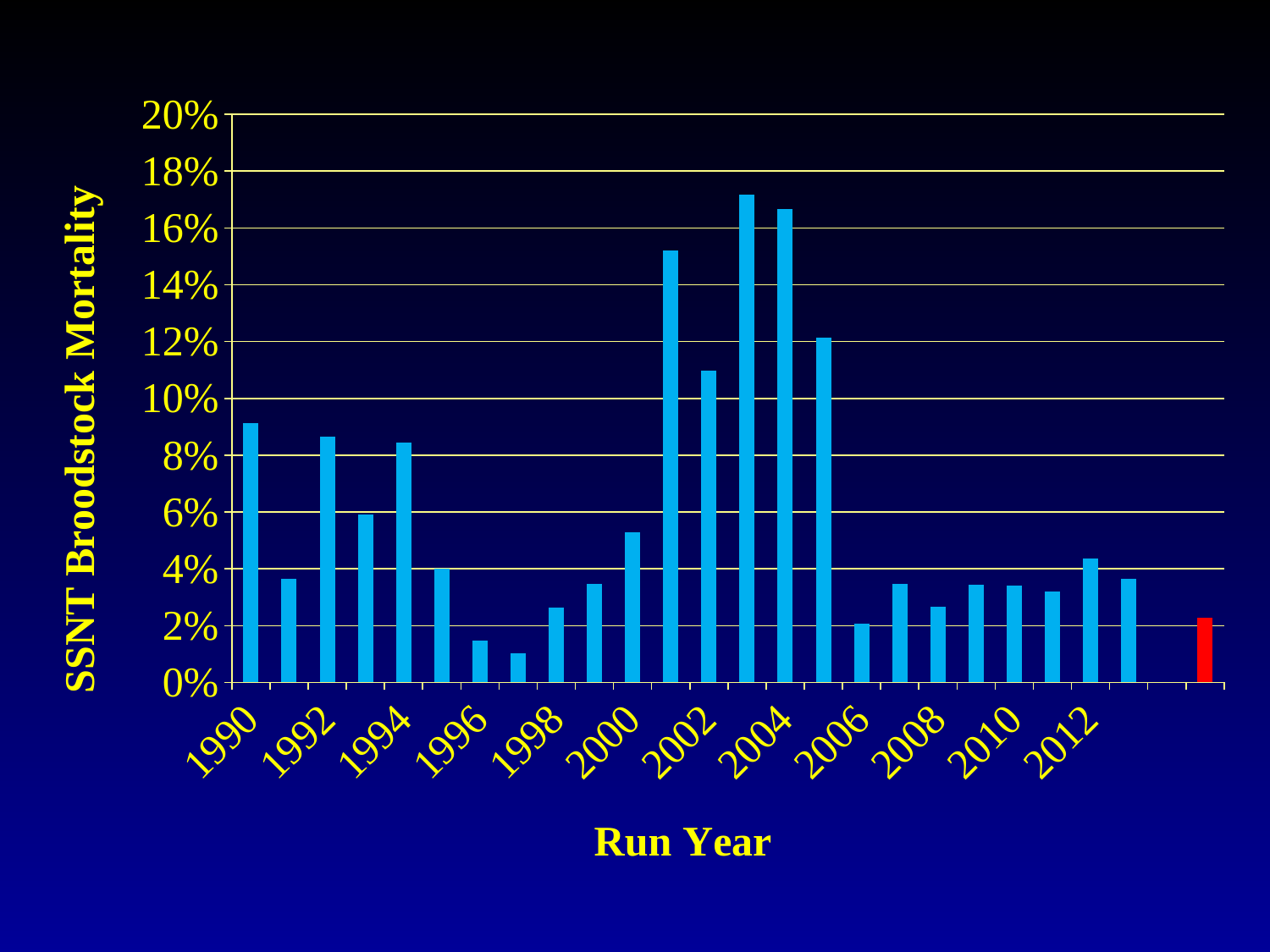
What is the label of the vertical axis? SSNT Broodstock Mortality Which run year has the higher SSNT broodstock mortality, 1990 or 1991? 1990 Is the SSNT broodstock mortality for 1997 greater or less than 2%? less What is the label of the horizontal axis? Run Year Which run year has the higher SSNT broodstock mortality, 2001 or 2002? 2001 Is the SSNT broodstock mortality for 2001 greater or less than 14%? greater Is the SSNT broodstock mortality for 2003 greater or less than 16%? greater What kind of chart is shown on the slide? bar chart Which run year has the highest SSNT broodstock mortality? 2003 Does SSNT broodstock mortality rise or fall from 2003 to 2006? fall Which run year has the lowest SSNT broodstock mortality? 1997